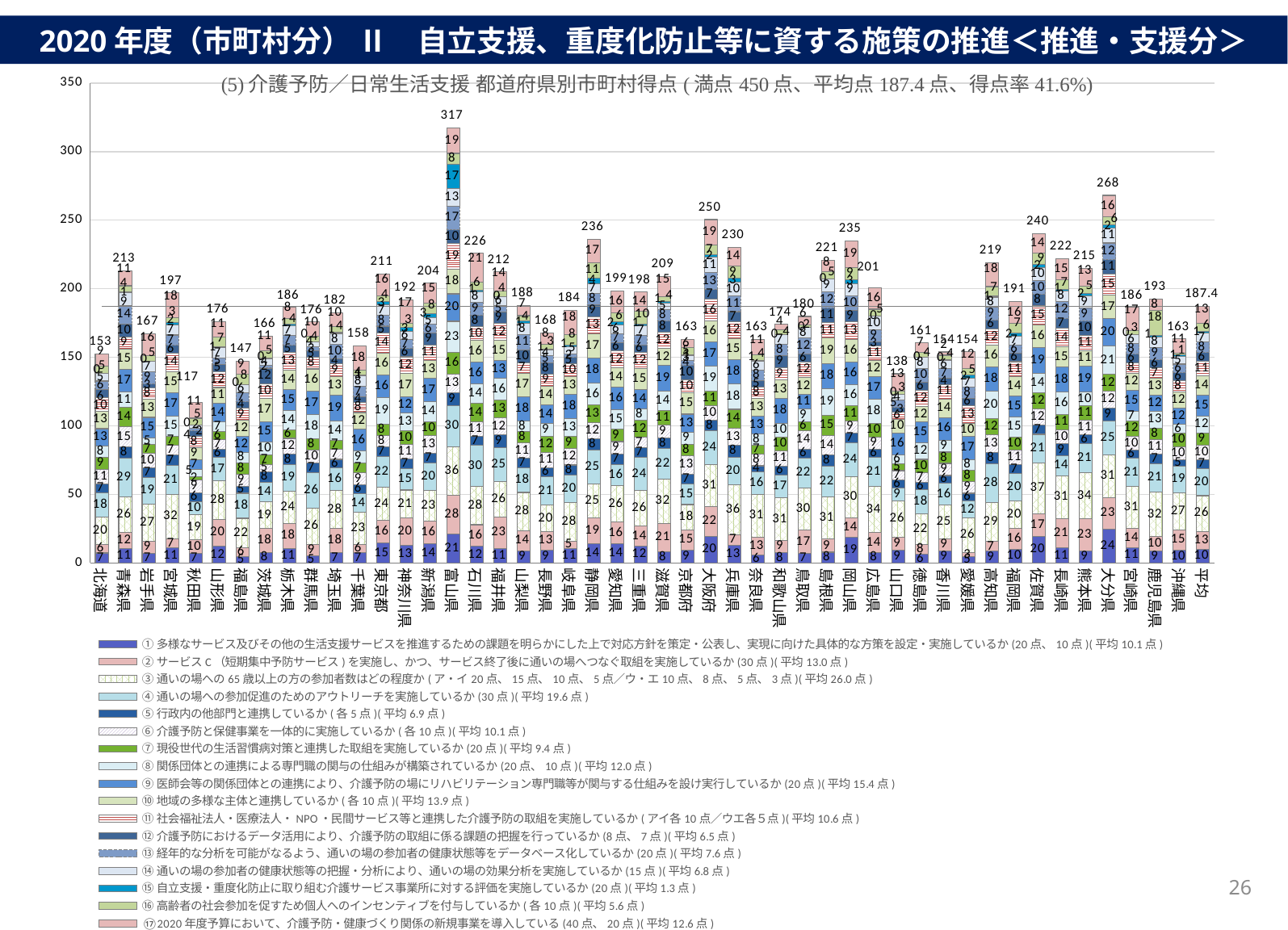
Is the total score for 秋田県 greater or less than 150? less What is the difference between the total scores of 富山県 and 大分県? 49 What is the total score for 北海道? 153 How many series does the legend list? 17 According to the chart title, what is the maximum possible score (満点)? 450 点 Which has a higher total score, 青森県 or 山口県? 青森県 What is the value shown for the 平均 bar? 187.4 What kind of chart is shown on the slide? stacked bar chart Which prefecture has the lowest total score? 秋田県 What is the total score for 大分県? 268 What is the total score for 大阪府? 250 Which prefecture has the highest total score? 富山県